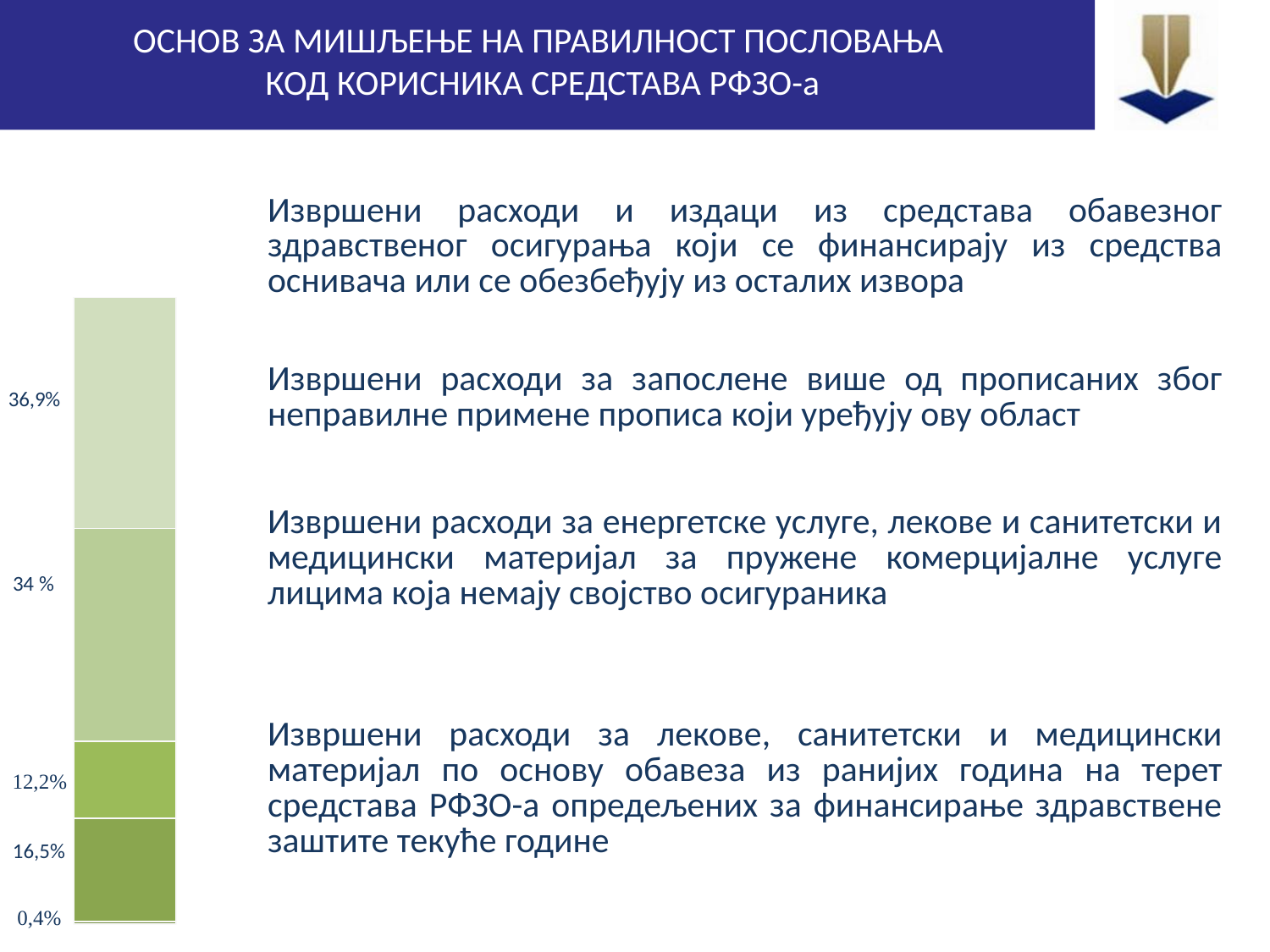
Which is larger, the 34 % segment or the 12,2% segment of the stacked bar? the 34 % segment What is the value of the second segment from the top of the stacked bar? 34 % Which segment of the stacked bar has the largest value? the topmost segment, 36,9% What is the value of the bottom segment of the stacked bar? 0,4% How many segments does the stacked bar on the slide contain? 5 What is the difference between the 16,5% segment and the 12,2% segment of the stacked bar? 4,3% What is the value of the second segment from the bottom of the stacked bar? 16,5% What kind of chart is shown on the slide? stacked bar chart What is the difference between the largest segment (36,9%) and the smallest segment (0,4%) of the stacked bar? 36,5% What is the total of all segments in the stacked bar? 100% Which segment of the stacked bar has the smallest value? the bottom segment, 0,4% What is the value of the topmost segment of the stacked bar? 36,9%